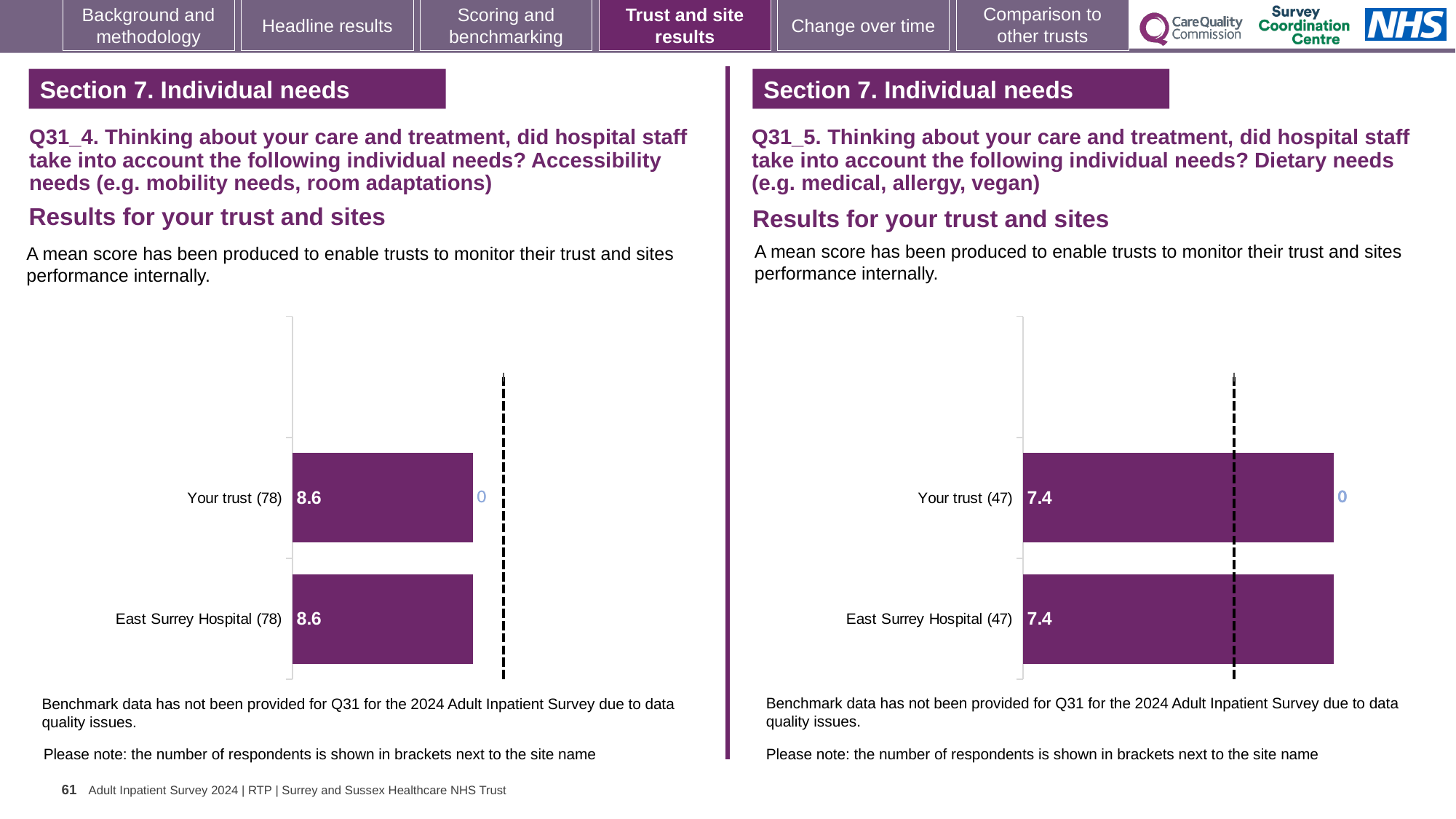
What kind of chart is used on the left (Q31_4, accessibility needs)? Bar chart On the left chart (Q31_4, accessibility needs), what is the difference between the scores for Your trust and East Surrey Hospital? 0 On the left chart (Q31_4, accessibility needs), what is the mean score for East Surrey Hospital? 8.6 On the right chart (Q31_5, dietary needs), what is the difference between the scores for Your trust and East Surrey Hospital? 0 On the left chart (Q31_4, accessibility needs), what is the mean score for Your trust? 8.6 On the right chart (Q31_5, dietary needs), what is the mean score for East Surrey Hospital? 7.4 On the right chart (Q31_5, dietary needs), how many respondents are shown in brackets for East Surrey Hospital? 47 On the left chart (Q31_4, accessibility needs), how many respondents are shown in brackets for Your trust? 78 On the right chart (Q31_5, dietary needs), what is the mean score for Your trust? 7.4 How many bars are plotted on the right chart (Q31_5, dietary needs)? 2 How many bars are plotted on the left chart (Q31_4, accessibility needs)? 2 Is the Your trust score on the left chart (Q31_4) larger or smaller than the Your trust score on the right chart (Q31_5)? Larger